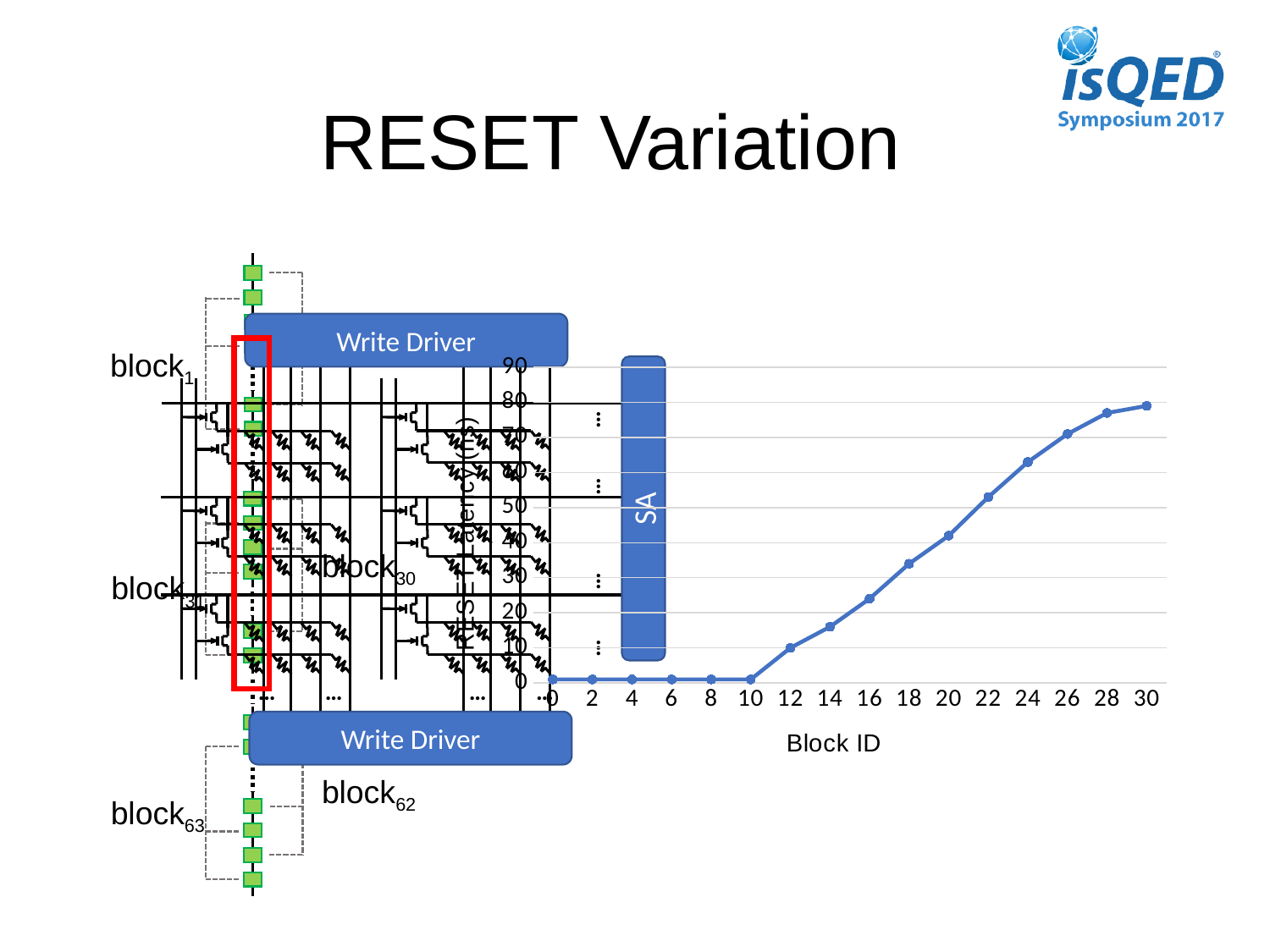
Do the values rise or fall as Block ID increases from 10 to 30? rise Is the value for Block ID 20 greater or less than 50? less Is the value for Block ID 30 greater or less than 70? greater Which Block ID has the highest value on the chart? 30 Is the value for Block ID 16 greater or less than 30? less What is the x-axis title of the chart? Block ID What kind of chart is shown on the slide? line chart How many data points are plotted on the line? 16 Which has the larger value, Block ID 14 or Block ID 20? Block ID 20